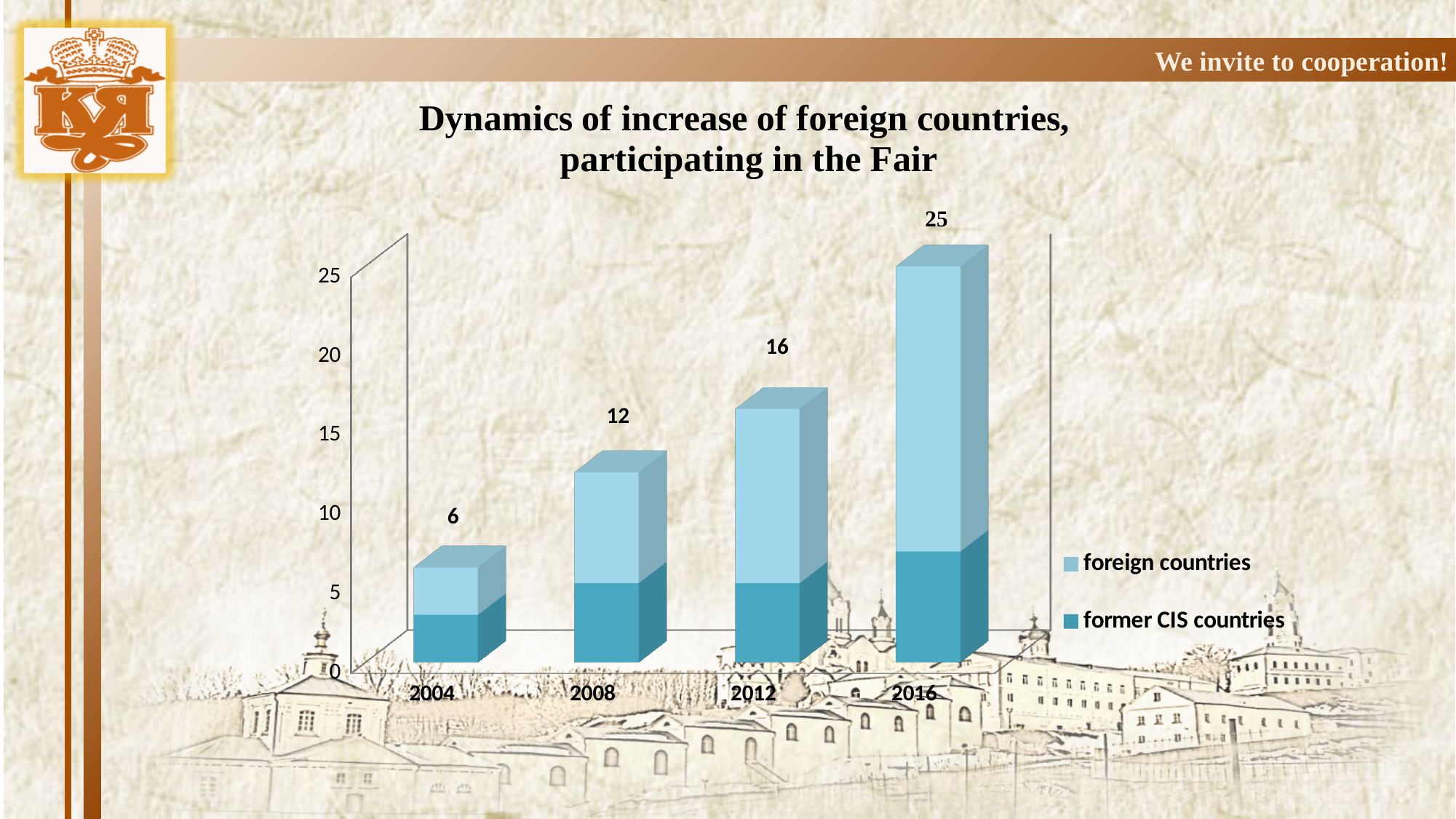
How many series does the legend list? 2 How many years are shown on the x axis? 4 Which year has the highest total value? 2016 What is the difference between the total values for 2016 and 2004? 19 What is the total value shown for 2012? 16 What type of chart is shown on the slide? bar chart Which year has a larger total value, 2008 or 2012? 2012 What is the total value shown for 2016? 25 Do the total values rise or fall from 2004 to 2016? rise What is the total value shown for 2008? 12 What is the total value shown for 2004? 6 Which year has the lowest total value? 2004